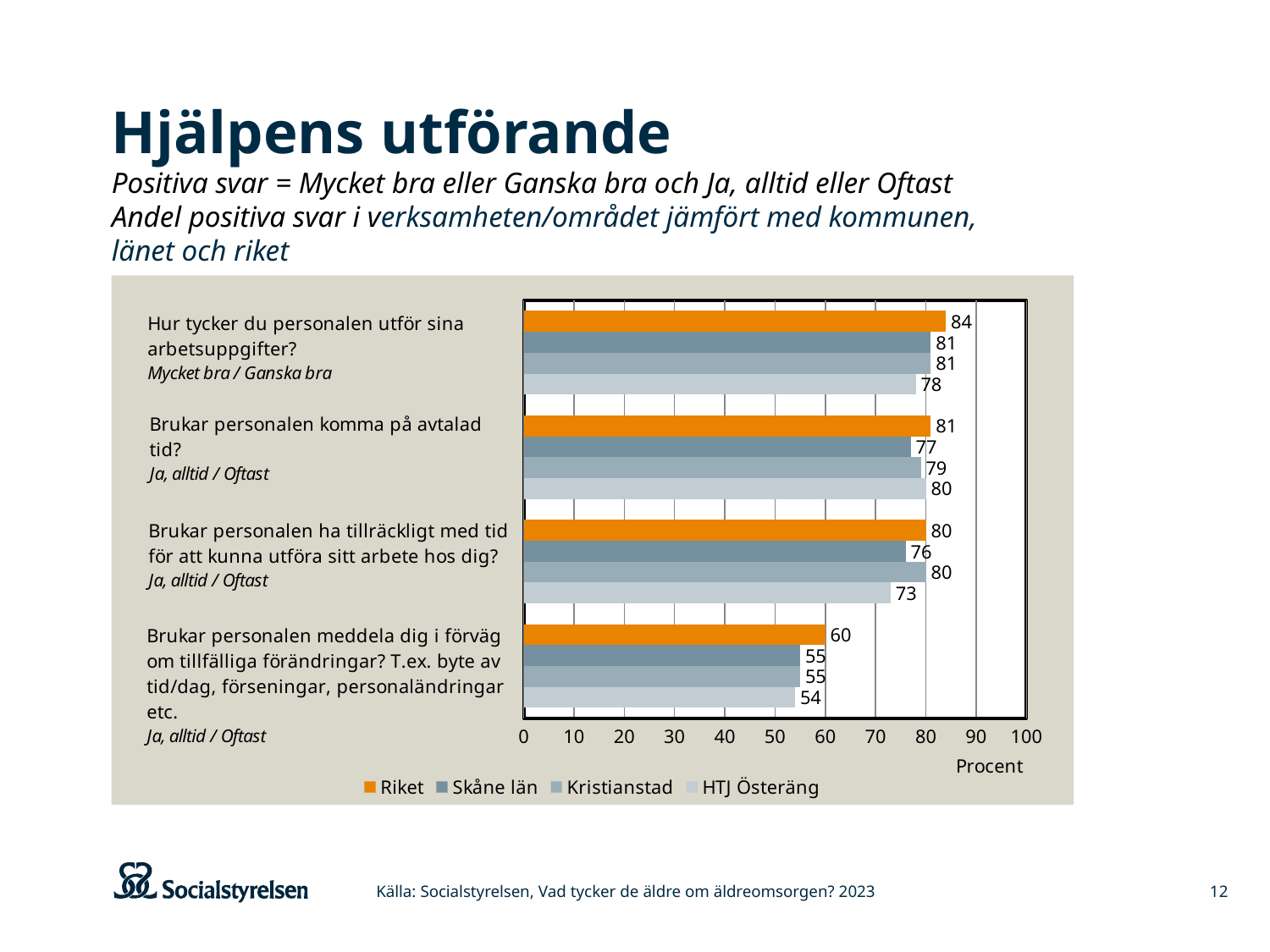
What is the label of the x axis? Procent Which series has the highest value for the question "Hur tycker du personalen utför sina arbetsuppgifter?"? Riket What is the value for Skåne län for the question "Brukar personalen meddela dig i förväg om tillfälliga förändringar?"? 55 What is the difference between Riket and HTJ Österäng for the question "Brukar personalen ha tillräckligt med tid för att kunna utföra sitt arbete hos dig?"? 7 Which question has the lowest value for Riket? Brukar personalen meddela dig i förväg om tillfälliga förändringar? How many series does the legend list? 4 For the question "Brukar personalen komma på avtalad tid?", which is larger: Skåne län or HTJ Österäng? HTJ Österäng How many questions (categories) are shown in the chart? 4 What is the value for Kristianstad for the question "Brukar personalen komma på avtalad tid?"? 79 What kind of chart is shown on the slide? Bar chart What is the value for HTJ Österäng for the question "Brukar personalen ha tillräckligt med tid för att kunna utföra sitt arbete hos dig?"? 73 What is the value for Riket for the question "Hur tycker du personalen utför sina arbetsuppgifter?"? 84